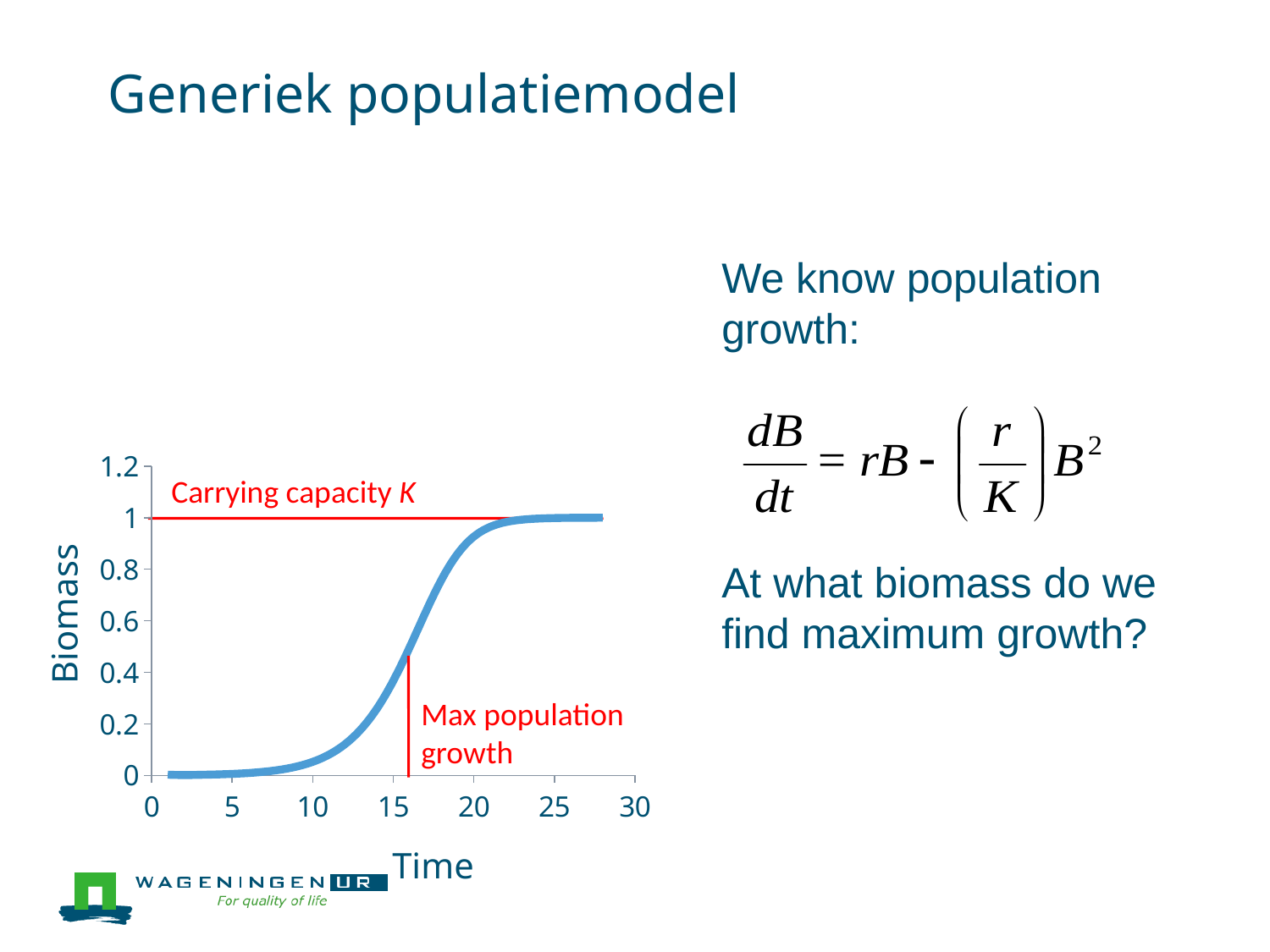
Is the biomass at time 15 greater or less than 0.8? less Is the biomass at time 10 greater or less than 0.4? less Is the biomass at time 25 greater or less than 0.8? greater Does biomass rise or fall as time increases along the x axis? rise At what biomass value is the horizontal red line labelled 'Carrying capacity K' drawn? 1 What is the highest value shown on the y axis? 1.2 What kind of chart is shown on the slide? line chart What is the label of the x axis? Time What is the label of the y axis? Biomass Is the biomass at time 25 larger or smaller than the biomass at time 10? larger